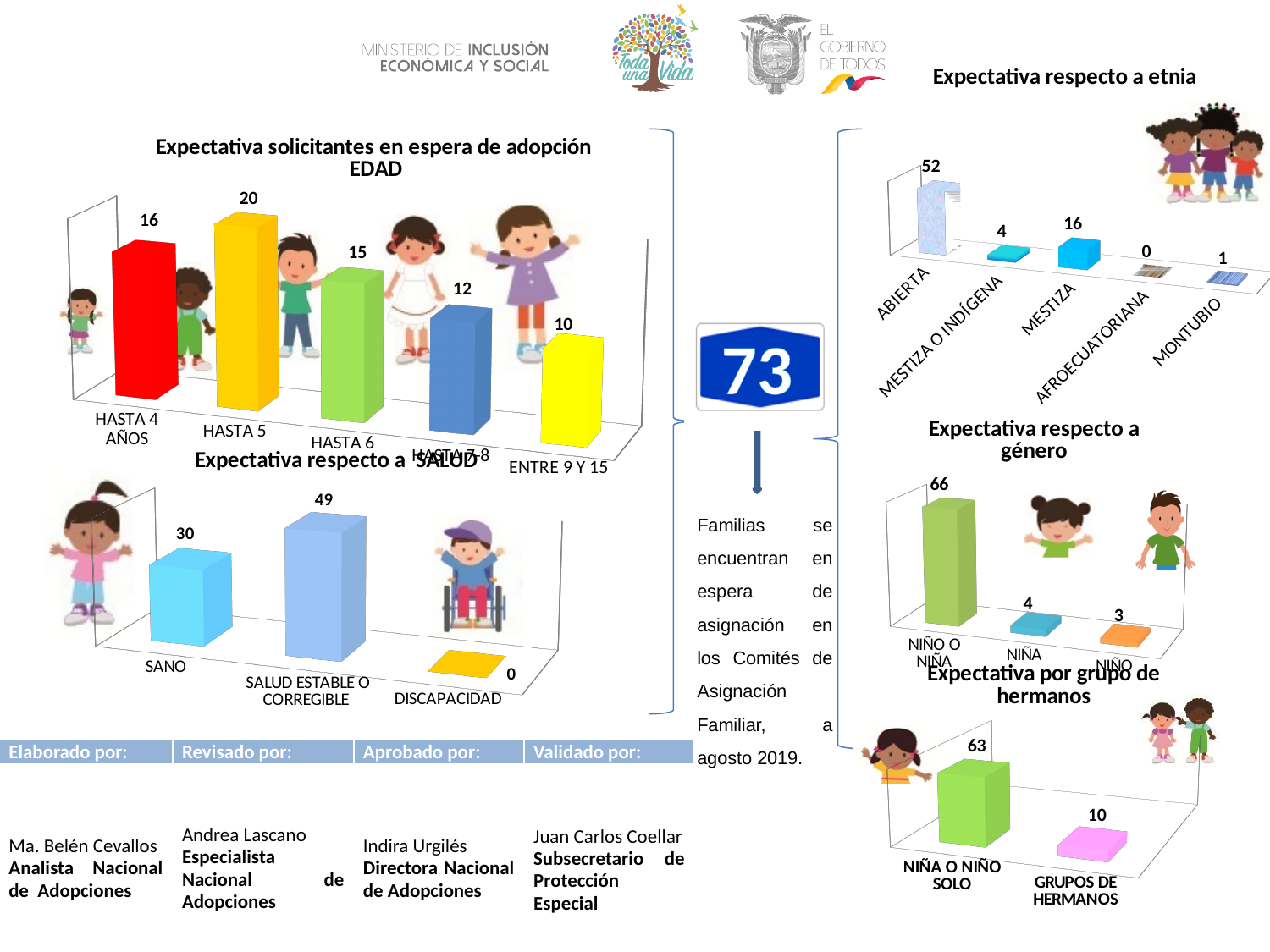
In the 'Expectativa respecto a SALUD' chart, what is the value for SALUD ESTABLE O CORREGIBLE? 49 In the 'Expectativa por grupo de hermanos' chart, what is the value for GRUPOS DE HERMANOS? 10 In the 'Expectativa respecto a etnia' chart, what is the value for MESTIZA? 16 In the 'Expectativa solicitantes en espera de adopción EDAD' chart, how many categories are shown? 5 In the 'Expectativa respecto a género' chart, what is the difference between NIÑA and NIÑO? 1 In the 'Expectativa respecto a etnia' chart, which is larger, MESTIZA O INDÍGENA or MONTUBIO? MESTIZA O INDÍGENA In the 'Expectativa solicitantes en espera de adopción EDAD' chart, what is the value for HASTA 5? 20 In the 'Expectativa respecto a género' chart, what is the value for NIÑO O NIÑA? 66 What type of chart is the 'Expectativa por grupo de hermanos' chart? Bar chart In the 'Expectativa respecto a SALUD' chart, what is the difference between SALUD ESTABLE O CORREGIBLE and SANO? 19 In the 'Expectativa solicitantes en espera de adopción EDAD' chart, which category has the lowest value? ENTRE 9 Y 15 In the 'Expectativa respecto a etnia' chart, which category has the highest value? ABIERTA